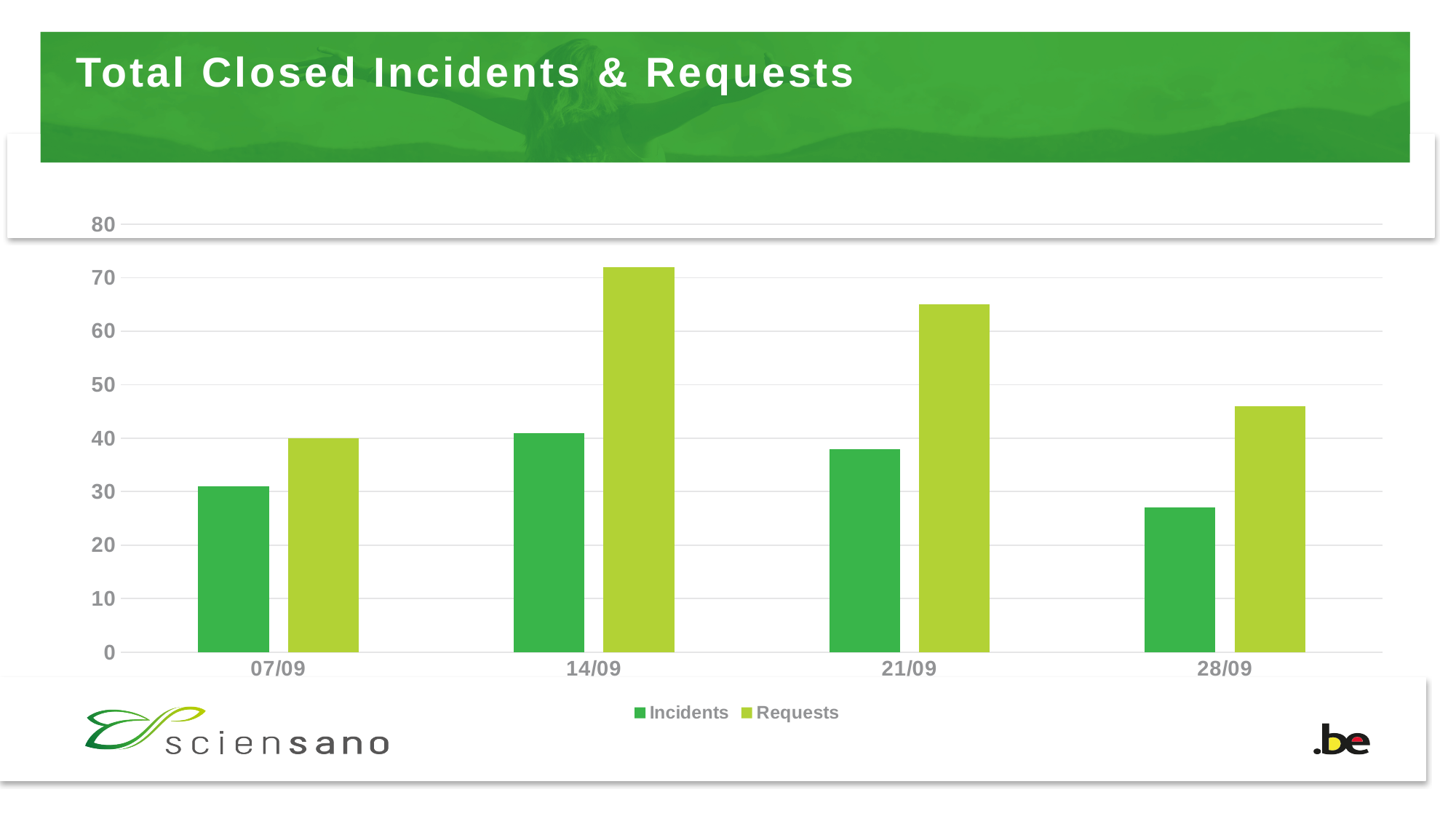
On which date is the Requests value lowest? 07/09 How many dates are shown on the x axis? 4 What type of chart is shown on the slide? bar chart Is the value for Incidents on 28/09 greater or less than 30? less How many series does the legend list? 2 On which date is the Incidents value lowest? 28/09 On 14/09, which is larger, Incidents or Requests? Requests Is the value for Requests on 21/09 greater or less than 60? greater What is the title of the chart? Total Closed Incidents & Requests Is the value for Requests on 28/09 greater or less than 50? less What is the value of Requests on 07/09? 40 On which date is the Requests value highest? 14/09